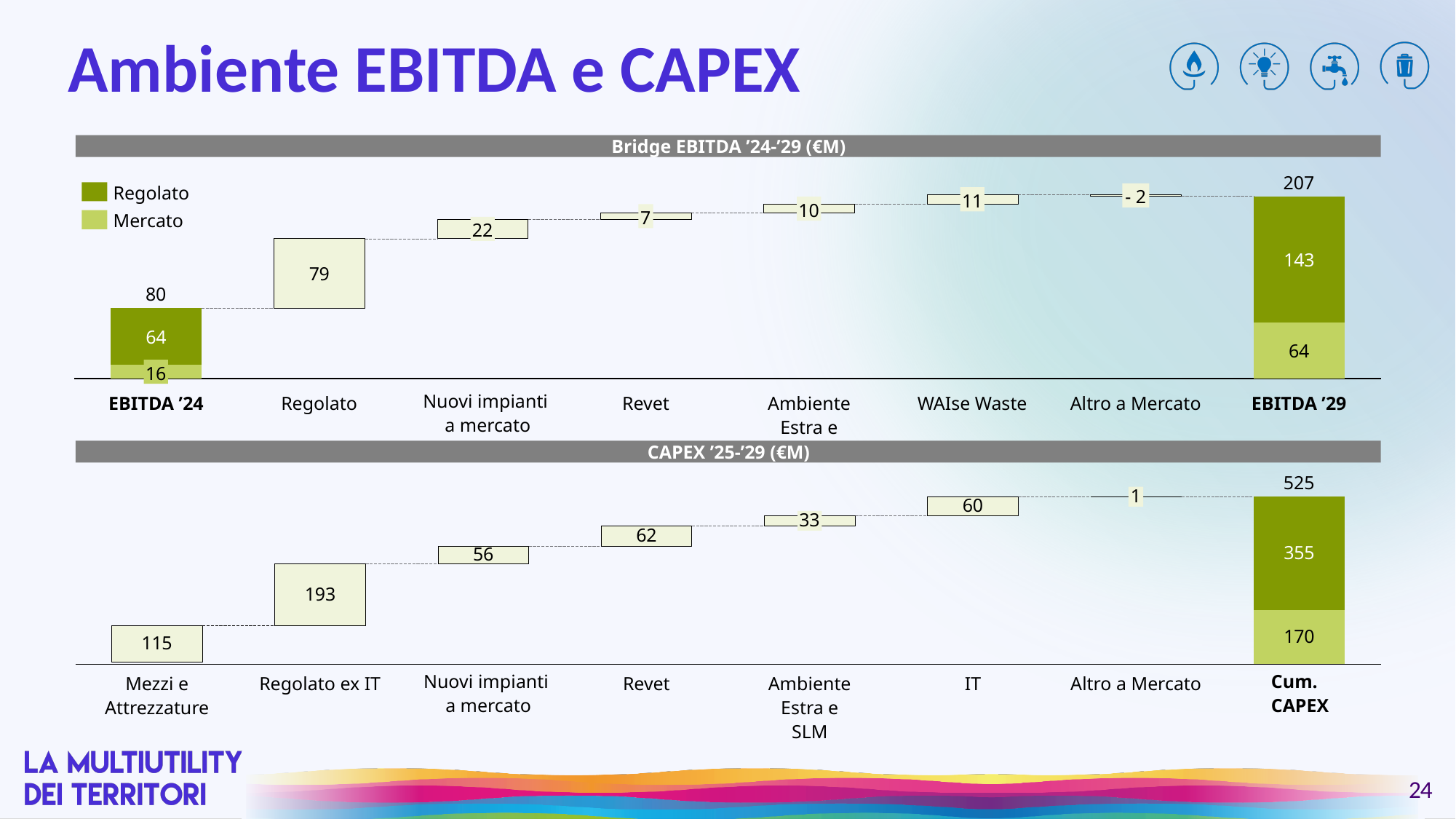
In the Bridge EBITDA '24-'29 chart, what is the value for EBITDA '29? 207 In the Bridge EBITDA '24-'29 chart, what is the value for Altro a Mercato? - 2 In the Bridge EBITDA '24-'29 chart, how many series does the legend list? 2 In the CAPEX '25-'29 chart, which is larger, Revet or IT? Revet In the CAPEX '25-'29 chart, what is the value for Regolato ex IT? 193 In the Bridge EBITDA '24-'29 chart, what is the value of the Regolato step? 79 In the Bridge EBITDA '24-'29 chart, what is the Regolato portion of the EBITDA '29 bar? 143 In the CAPEX '25-'29 chart, what is the value for Cum. CAPEX? 525 In the Bridge EBITDA '24-'29 chart, what is the value for EBITDA '24? 80 In the CAPEX '25-'29 chart, what is the Mercato portion of the Cum. CAPEX bar? 170 In the Bridge EBITDA '24-'29 chart, what is the difference between EBITDA '29 and EBITDA '24? 127 In the CAPEX '25-'29 chart, which step has the lowest value? Altro a Mercato